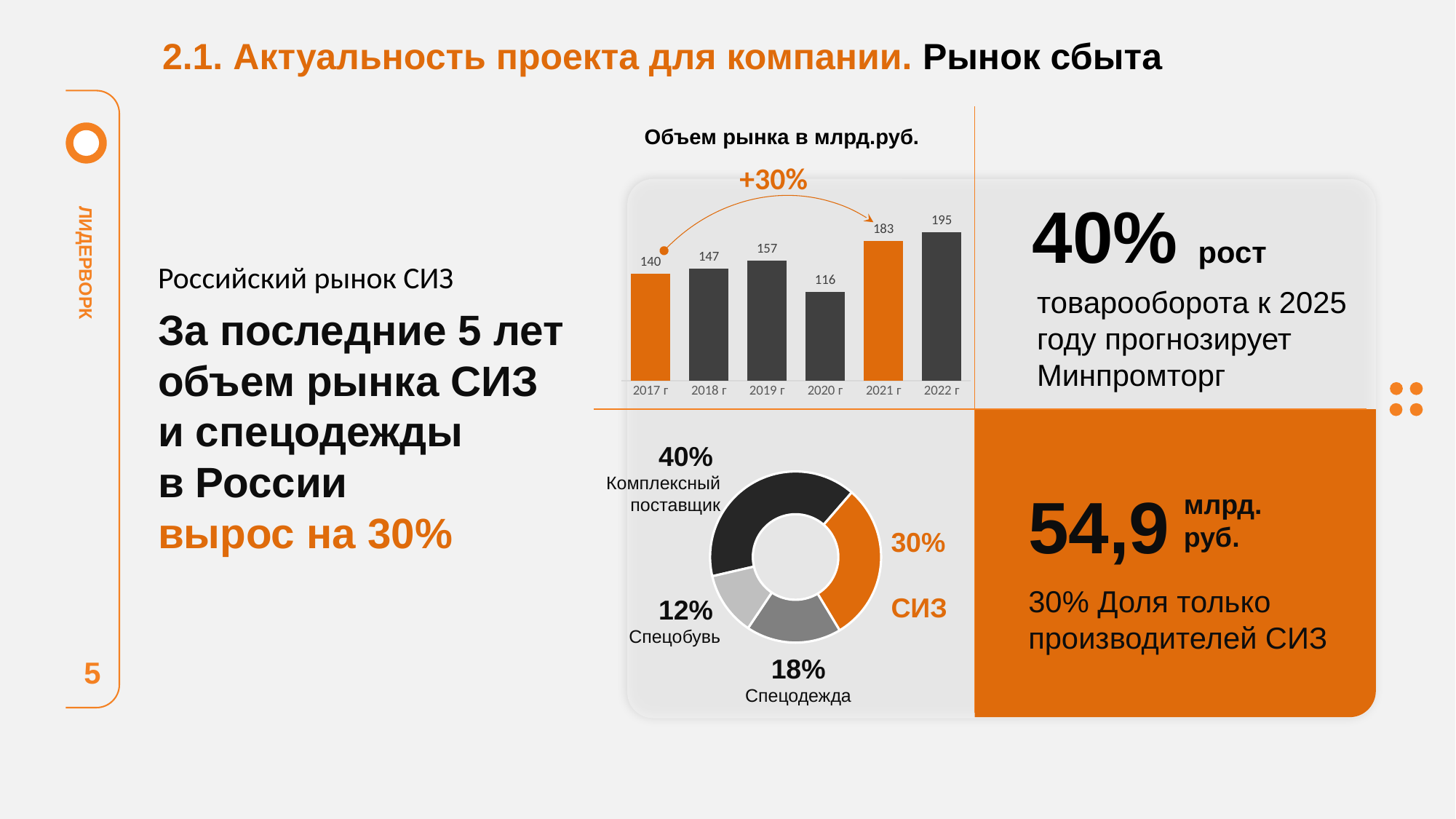
In the bar chart 'Объем рынка в млрд.руб.', which year has the lowest value? 2020 г In the donut chart at the bottom of the slide, what share does 'Спецобувь' have? 12% How many years are shown in the bar chart 'Объем рынка в млрд.руб.'? 6 In the bar chart 'Объем рынка в млрд.руб.', what is the value for 2021 г? 183 How many segments does the donut chart at the bottom of the slide have? 4 In the donut chart at the bottom of the slide, which segment has the largest share? Комплексный поставщик In the bar chart 'Объем рынка в млрд.руб.', which year has the highest value? 2022 г What type of chart is the chart titled 'Объем рынка в млрд.руб.'? bar chart In the bar chart 'Объем рынка в млрд.руб.', what is the value for 2019 г? 157 In the bar chart 'Объем рынка в млрд.руб.', which is larger, the value for 2018 г or the value for 2020 г? 2018 г In the bar chart 'Объем рынка в млрд.руб.', what is the difference between the values for 2022 г and 2017 г? 55 In the donut chart at the bottom of the slide, what is the difference between the shares of 'СИЗ' and 'Спецодежда'? 12%